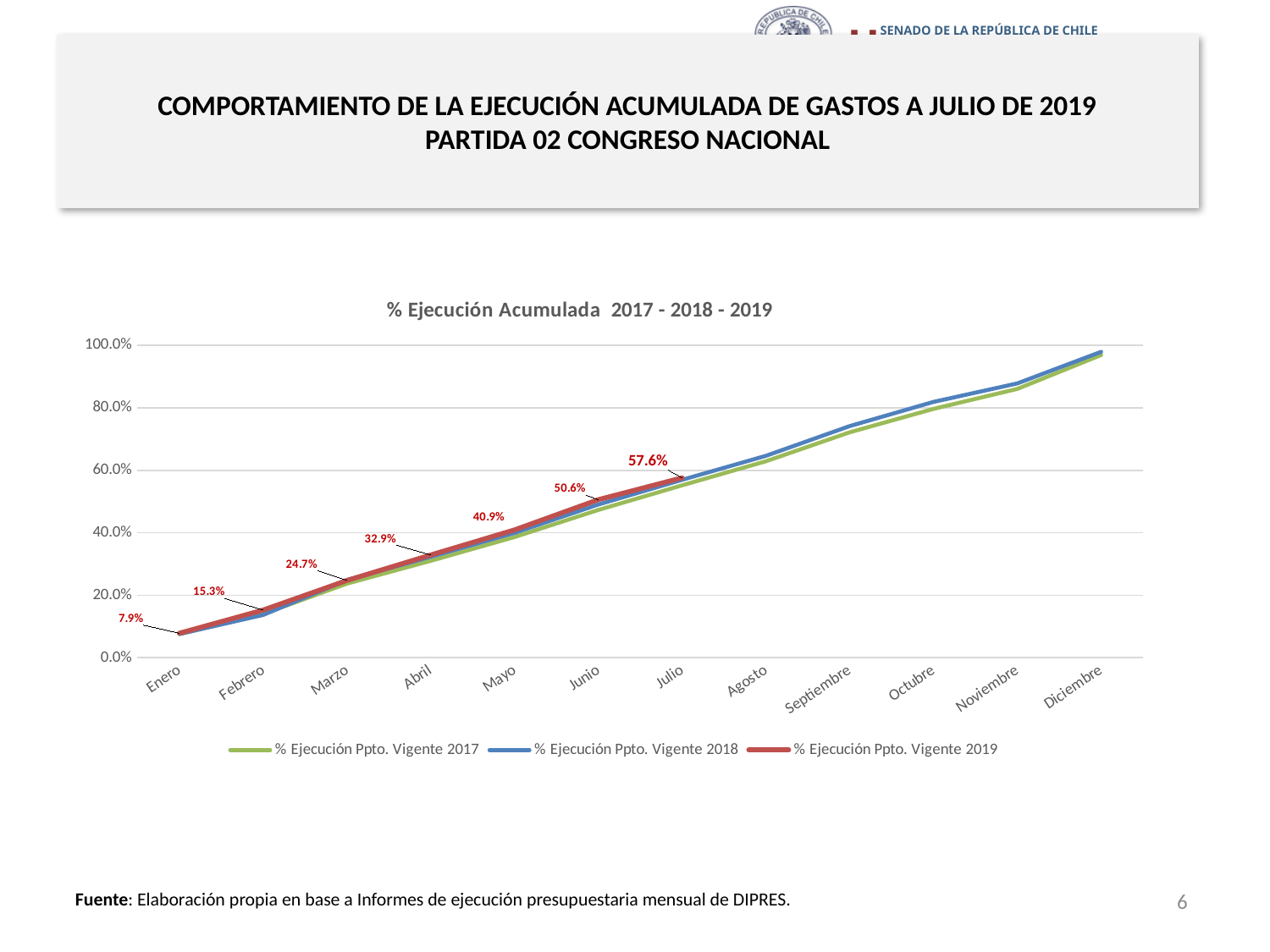
What kind of chart is shown on the slide? line chart Is the value for % Ejecución Ppto. Vigente 2018 in Diciembre greater or less than 80.0%? greater What is the difference between the 2019 values for Abril and Febrero? 17.6% How many series does the legend list? 3 Do the values for % Ejecución Ppto. Vigente 2019 rise or fall from Enero to Julio? rise How many months are shown on the x axis? 12 What is the difference between the 2019 values for Julio and Junio? 7.0% What is the value for % Ejecución Ppto. Vigente 2019 in Enero? 7.9% What is the title of the chart? % Ejecución Acumulada 2017 - 2018 - 2019 What is the value for % Ejecución Ppto. Vigente 2019 in Marzo? 24.7% What is the value for % Ejecución Ppto. Vigente 2019 in Julio? 57.6% Which month has the lowest value for % Ejecución Ppto. Vigente 2019? Enero